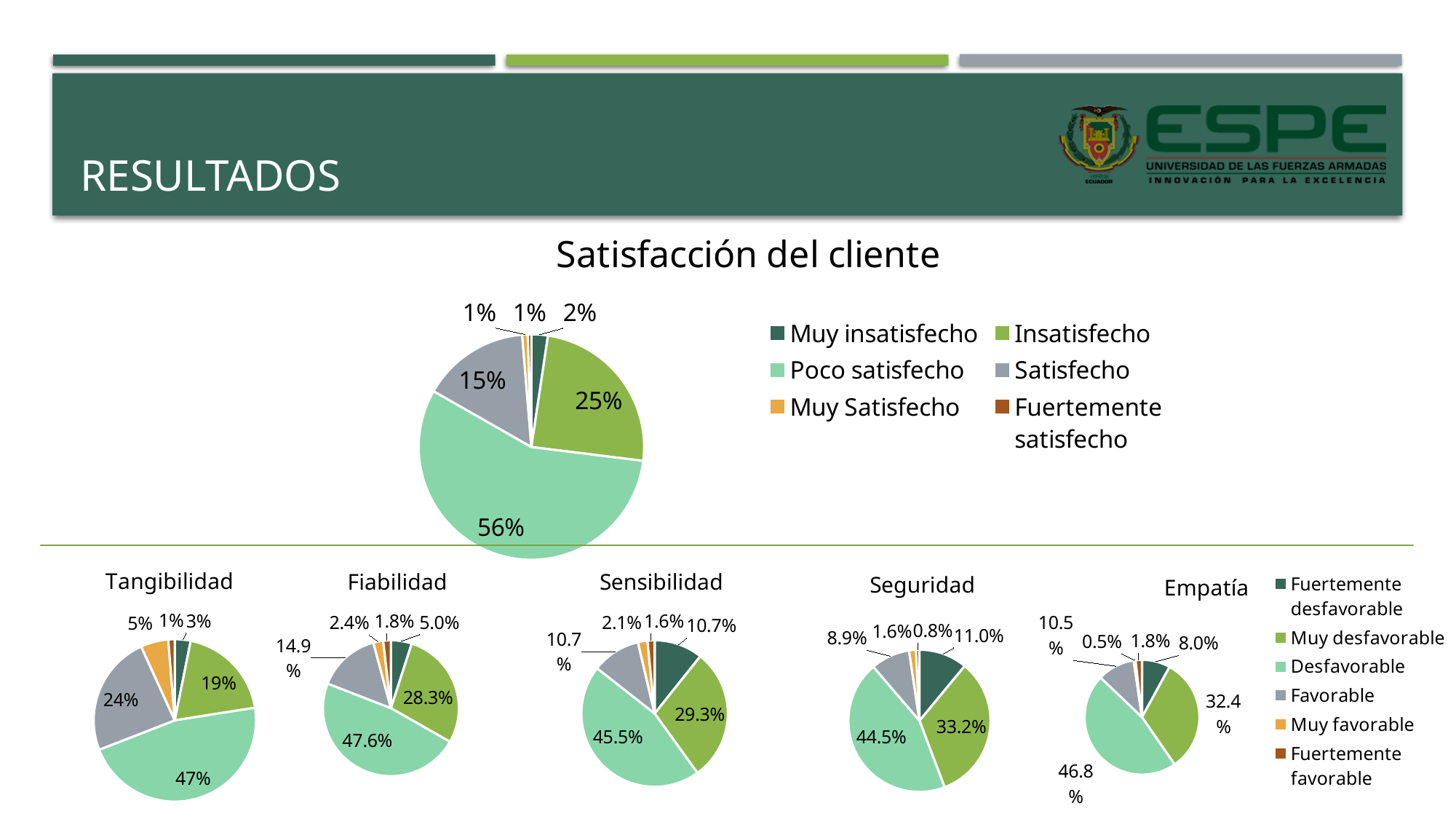
In the 'Tangibilidad' pie chart, what percentage is shown for Desfavorable? 47% In the 'Satisfacción del cliente' pie chart, what percentage is shown for Insatisfecho? 25% In the 'Sensibilidad' pie chart, what is the difference between the Desfavorable and Muy desfavorable slices? 16.2% In the 'Satisfacción del cliente' pie chart, what is the difference between the Insatisfecho and Satisfecho slices? 10% In the 'Seguridad' pie chart, what percentage is shown for Muy desfavorable? 33.2% In the 'Fiabilidad' pie chart, what percentage is shown for Favorable? 14.9% What type of chart is used for 'Satisfacción del cliente'? Pie chart In the 'Satisfacción del cliente' pie chart, what percentage is shown for Poco satisfecho? 56% How many entries does the legend of the 'Satisfacción del cliente' pie chart list? 6 In the 'Satisfacción del cliente' pie chart, which category has the largest slice? Poco satisfecho How many small pie charts are shown in the bottom row of the slide? 5 In the 'Empatía' pie chart, which is larger: the Desfavorable slice or the Muy desfavorable slice? Desfavorable